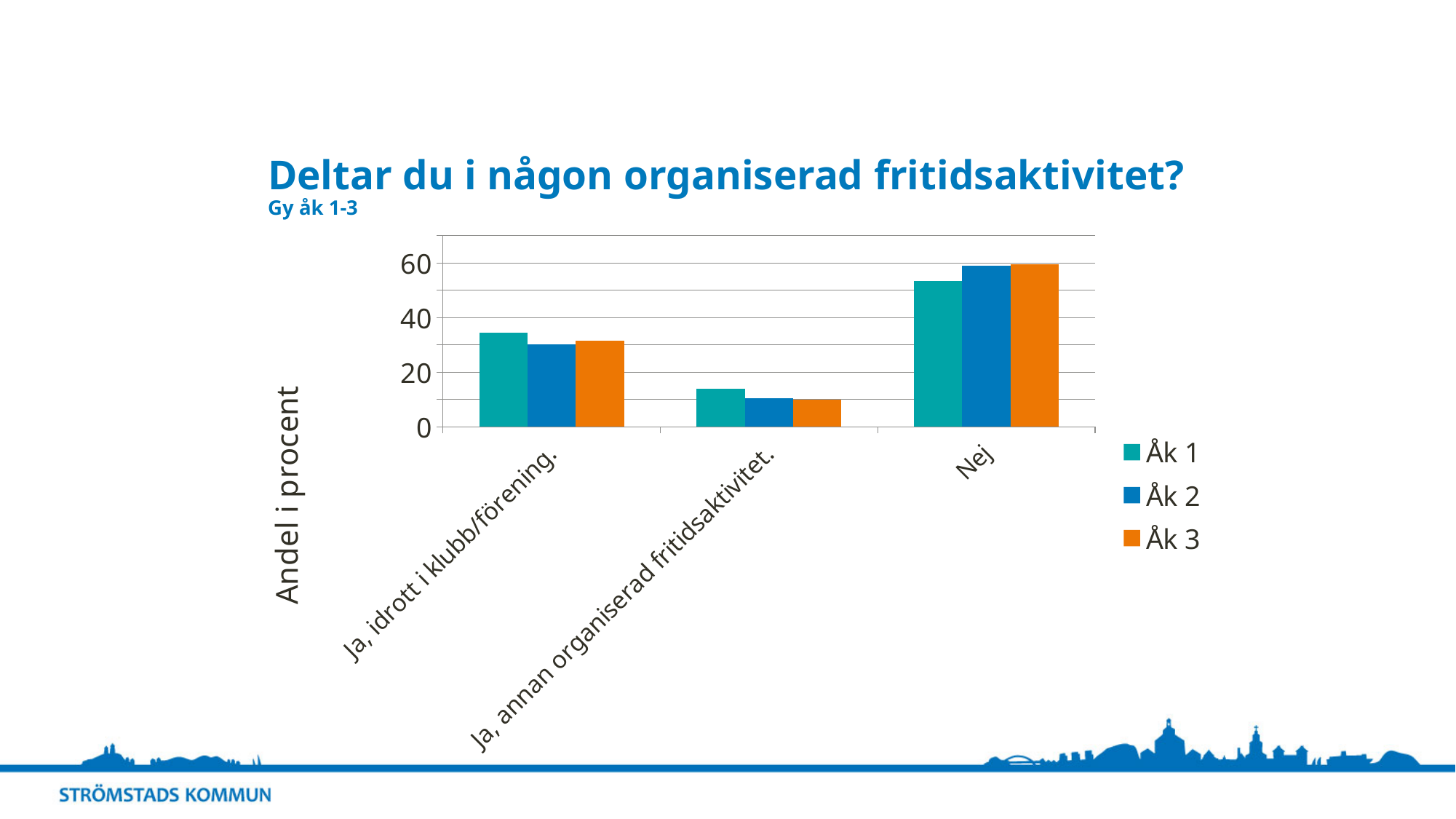
What is the label on the vertical axis of the chart? Andel i procent In the category 'Nej', which is larger: the value for Åk 1 or the value for Åk 2? Åk 2 What kind of chart is shown on the slide? bar chart Is the value for Åk 1 in the category 'Ja, annan organiserad fritidsaktivitet.' greater or less than 20? less In the category 'Ja, idrott i klubb/förening.', which is larger: the value for Åk 1 or the value for Åk 2? Åk 1 Which category has the highest value for Åk 1? Nej What is the title of the chart? Deltar du i någon organiserad fritidsaktivitet? How many categories are shown on the x axis of the chart? 3 Is the value for Åk 2 in the category 'Ja, idrott i klubb/förening.' greater or less than 20? greater How many series does the legend list? 3 Which category has the lowest value for Åk 2? Ja, annan organiserad fritidsaktivitet. Is the value for Åk 3 in the category 'Nej' greater or less than 40? greater